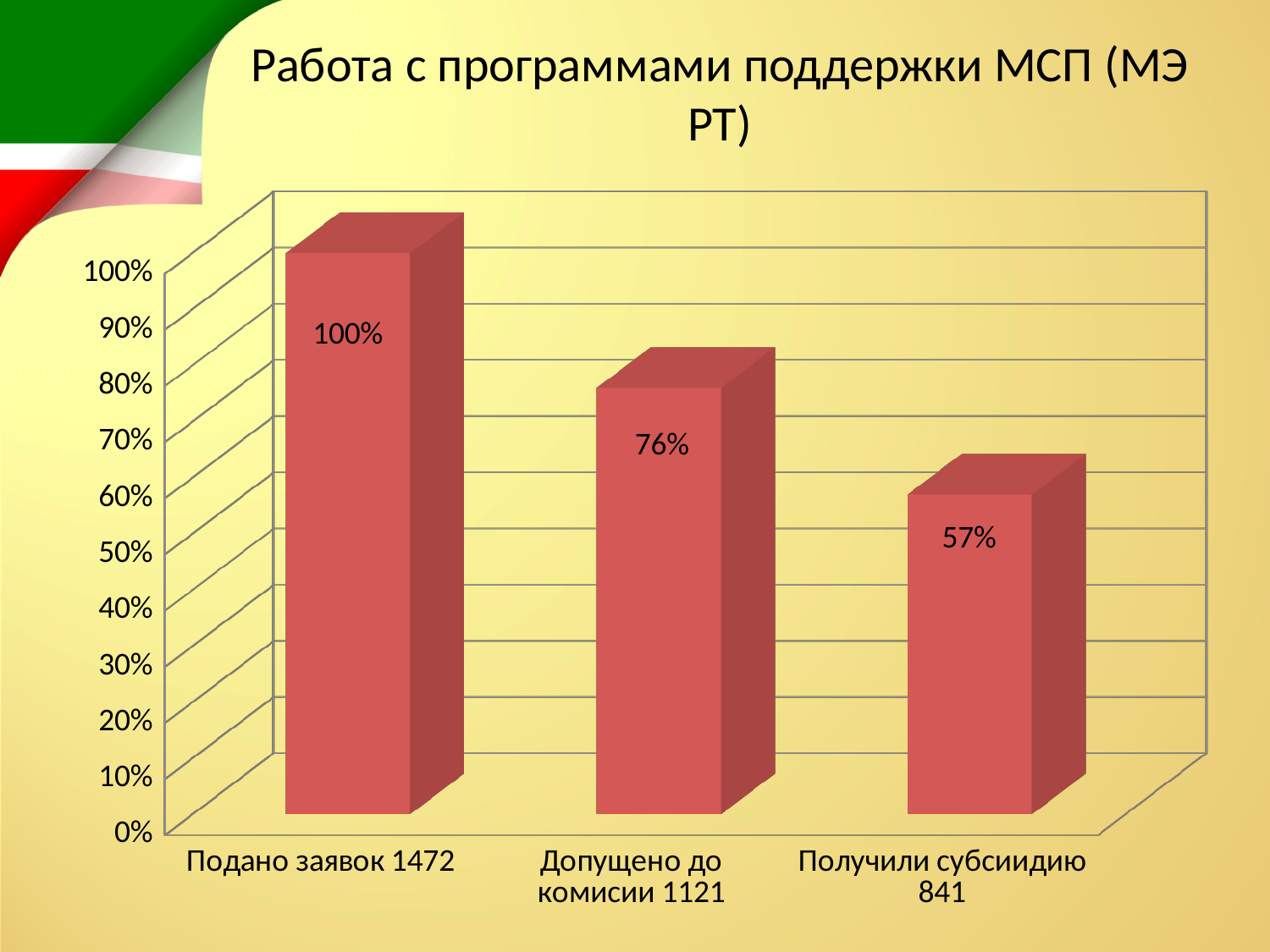
What kind of chart is shown on the slide? bar chart Is the value for "Получили субсиидию 841" greater or less than 60%? less What is the value for "Допущено до комисии 1121"? 76% What is the difference between the values for "Подано заявок 1472" and "Допущено до комисии 1121"? 24% Do the values rise or fall from left to right across the categories? fall What is the value for "Получили субсиидию 841"? 57% How many categories are shown in the chart? 3 What is the difference between the values for "Допущено до комисии 1121" and "Получили субсиидию 841"? 19% Which category has the highest value? Подано заявок 1472 Which category has the lowest value? Получили субсиидию 841 Which is larger, the value for "Допущено до комисии 1121" or the value for "Получили субсиидию 841"? Допущено до комисии 1121 What is the value for "Подано заявок 1472"? 100%